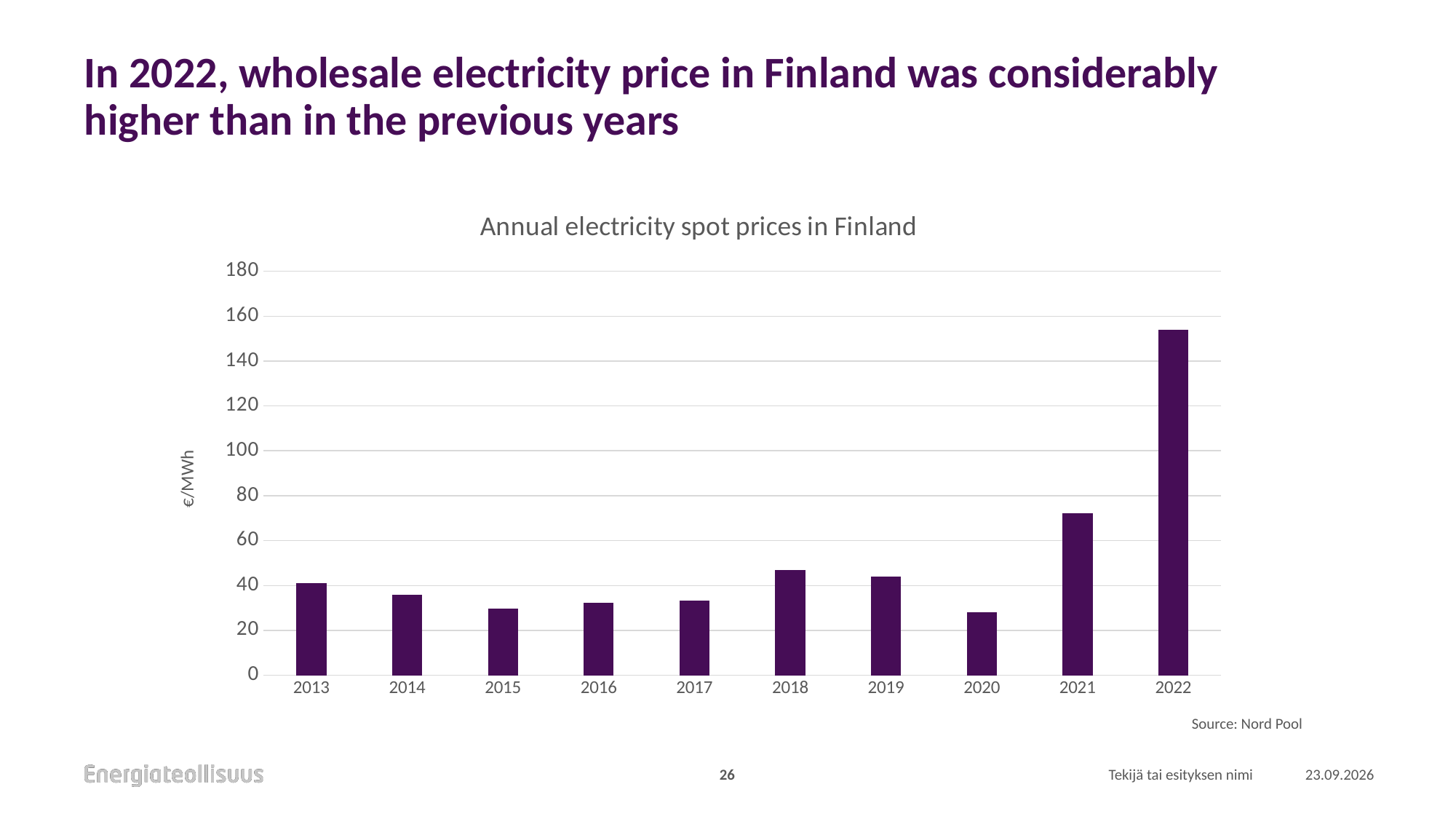
Do the values rise or fall from 2020 to 2022? rise Which is larger, the value for 2021 or the value for 2013? 2021 Is the value for 2018 greater or less than 40? greater Is the value for 2021 greater or less than 80? less Is the value for 2022 greater or less than 140? greater Which year has the highest annual electricity spot price in the chart? 2022 What kind of chart is shown on the slide? Bar chart How many years are shown on the x axis of the chart? 10 Which is larger, the value for 2018 or the value for 2020? 2018 What unit is shown on the y axis of the chart? €/MWh